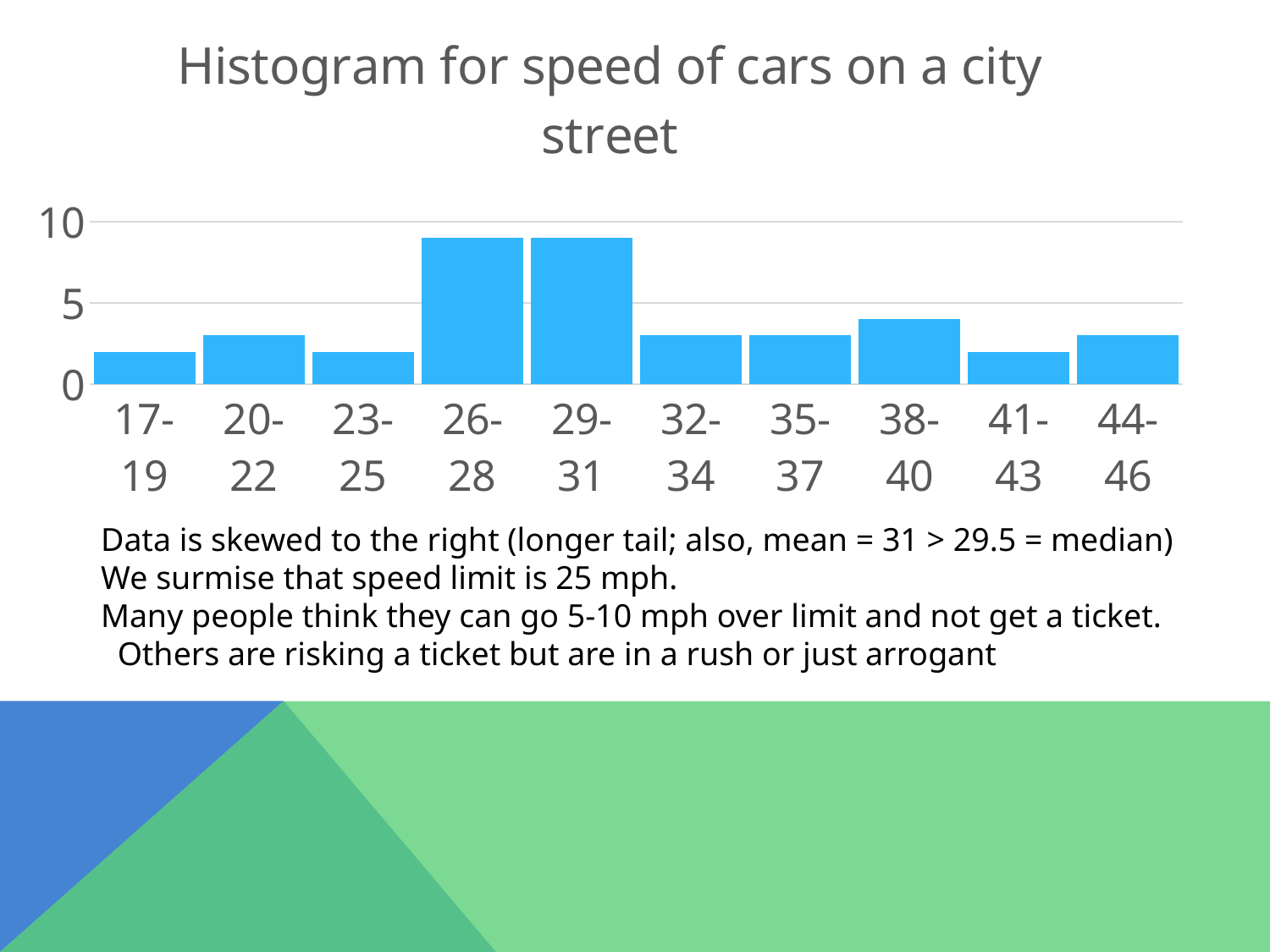
What is the title of the chart? Histogram for speed of cars on a city street Is the value for the 26-28 bin greater or less than 10? less How many speed bins are shown on the x axis? 10 Which bin has the larger value, 26-28 or 32-34? 26-28 Is the value for the 38-40 bin greater or less than 5? less What colour are the bars in the chart? blue Which bin has the larger value, 38-40 or 41-43? 38-40 Is the value for the 29-31 bin greater or less than 5? greater What kind of chart is shown on the slide? bar chart